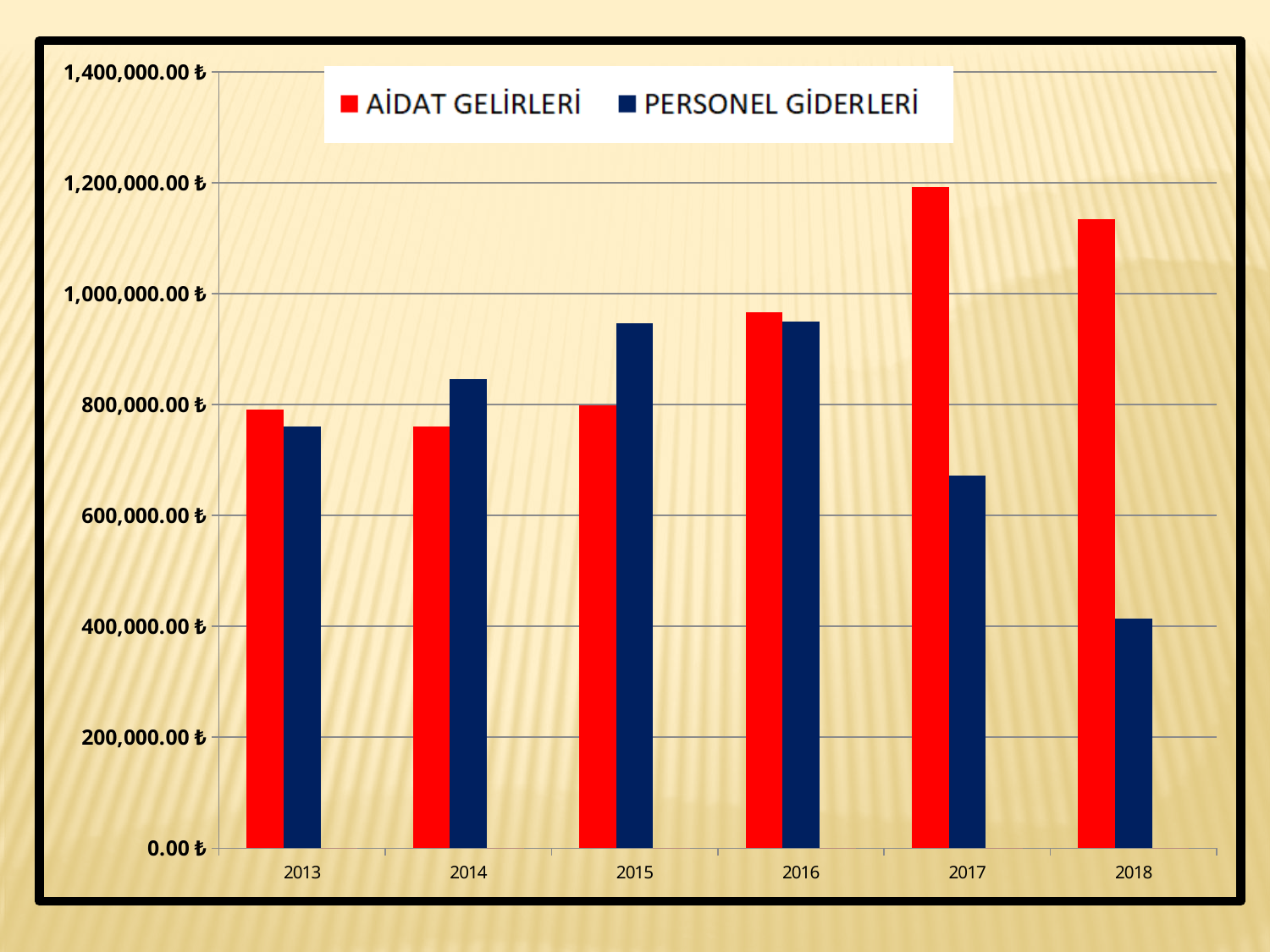
Which year has the highest value for AİDAT GELİRLERİ? 2017 Is the value for PERSONEL GİDERLERİ in 2018 greater or less than 600,000.00 ₺? less What kind of chart is shown on the slide? bar chart In 2018, which is larger: AİDAT GELİRLERİ or PERSONEL GİDERLERİ? AİDAT GELİRLERİ Is the value for PERSONEL GİDERLERİ in 2014 greater or less than 800,000.00 ₺? greater Do the PERSONEL GİDERLERİ values rise or fall from 2016 to 2018? fall Which year has the lowest value for PERSONEL GİDERLERİ? 2018 Is the value for AİDAT GELİRLERİ in 2017 greater or less than 1,000,000.00 ₺? greater How many series does the legend list? 2 How many years are shown on the x axis? 6 In 2015, which is larger: AİDAT GELİRLERİ or PERSONEL GİDERLERİ? PERSONEL GİDERLERİ